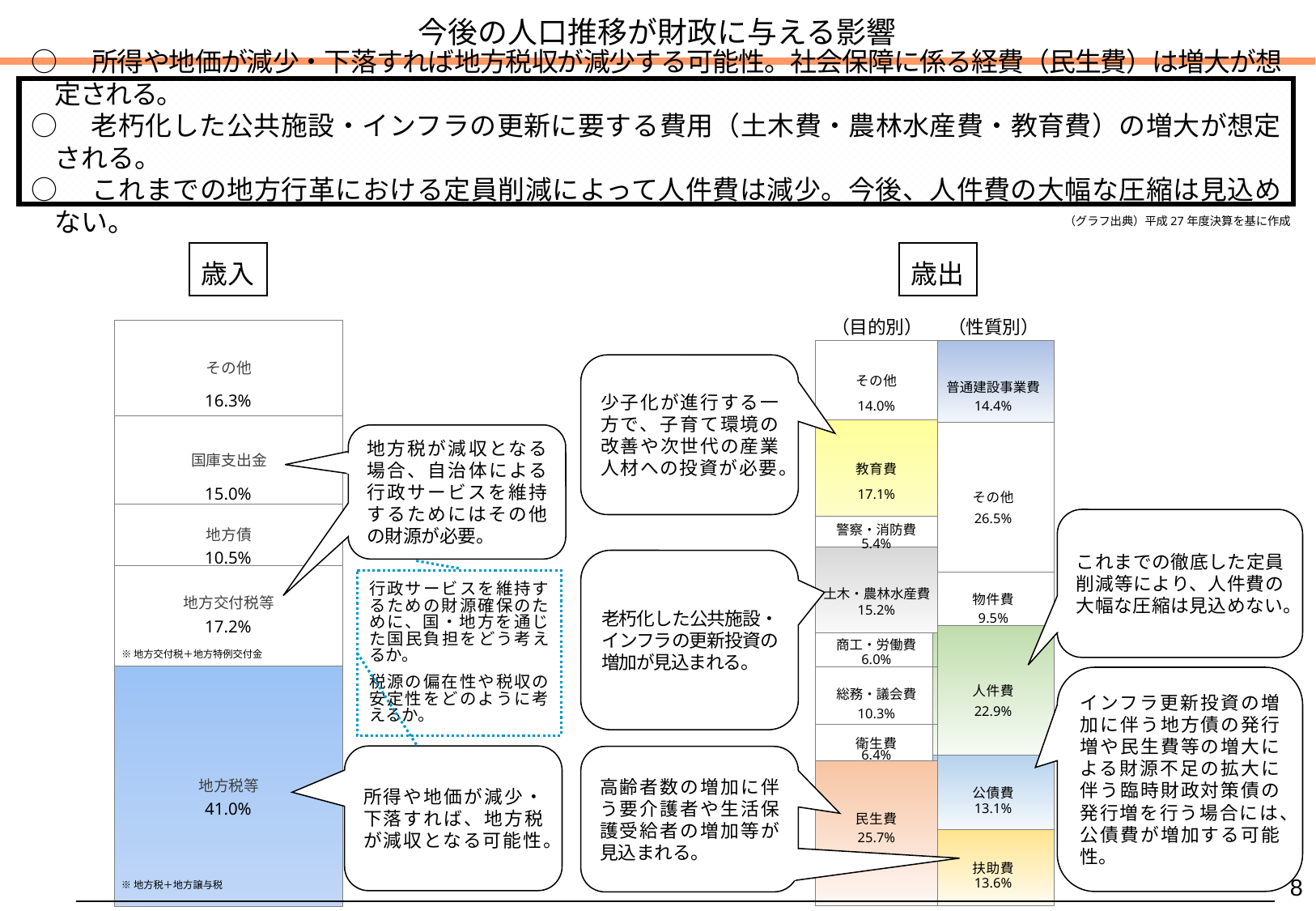
In the 歳出（目的別） chart, which category has the largest share? 民生費 In the 歳入 chart, how many categories are shown? 5 In the 歳入 chart, what is the value for 地方税等? 41.0% In the 歳入 chart, what is the difference between 地方交付税等 and 国庫支出金? 2.2% In the 歳出（目的別） chart, how many categories are shown? 8 In the 歳出（性質別） chart, what is the value for 人件費? 22.9% In the 歳出（性質別） chart, what is the difference between 扶助費 and 公債費? 0.5% In the 歳入 chart, which category has the smallest share? 地方債 What kind of chart is the 歳入 chart? Stacked bar chart In the 歳出（目的別） chart, what is the value for 民生費? 25.7% In the 歳出（目的別） chart, which is larger, 教育費 or 土木・農林水産費? 教育費 In the 歳出（性質別） chart, which category has the smallest share? 物件費